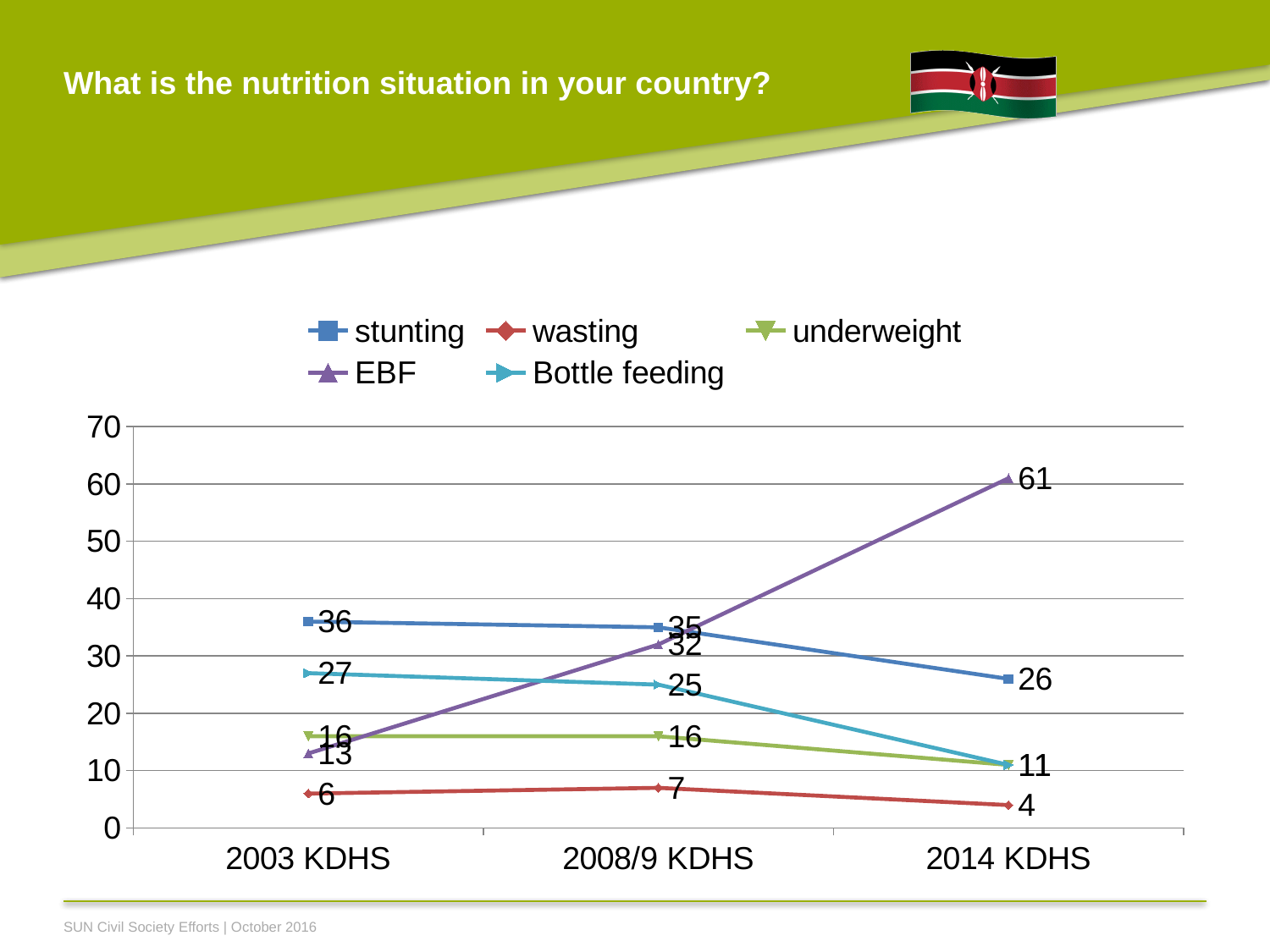
What kind of chart is shown on the slide? line chart What is the value for Bottle feeding at 2008/9 KDHS? 25 By how much did stunting fall from 2003 KDHS to 2014 KDHS? 10 What is the value for wasting at 2008/9 KDHS? 7 Which series has the highest value at 2014 KDHS? EBF How many survey points are shown on the x axis? 3 At 2003 KDHS, which is larger: stunting or Bottle feeding? stunting Which series has the lowest value at 2003 KDHS? wasting What is the value for stunting at 2003 KDHS? 36 What is the value for EBF at 2014 KDHS? 61 How many series does the legend list? 5 Does the EBF line rise or fall from 2003 KDHS to 2014 KDHS? rise